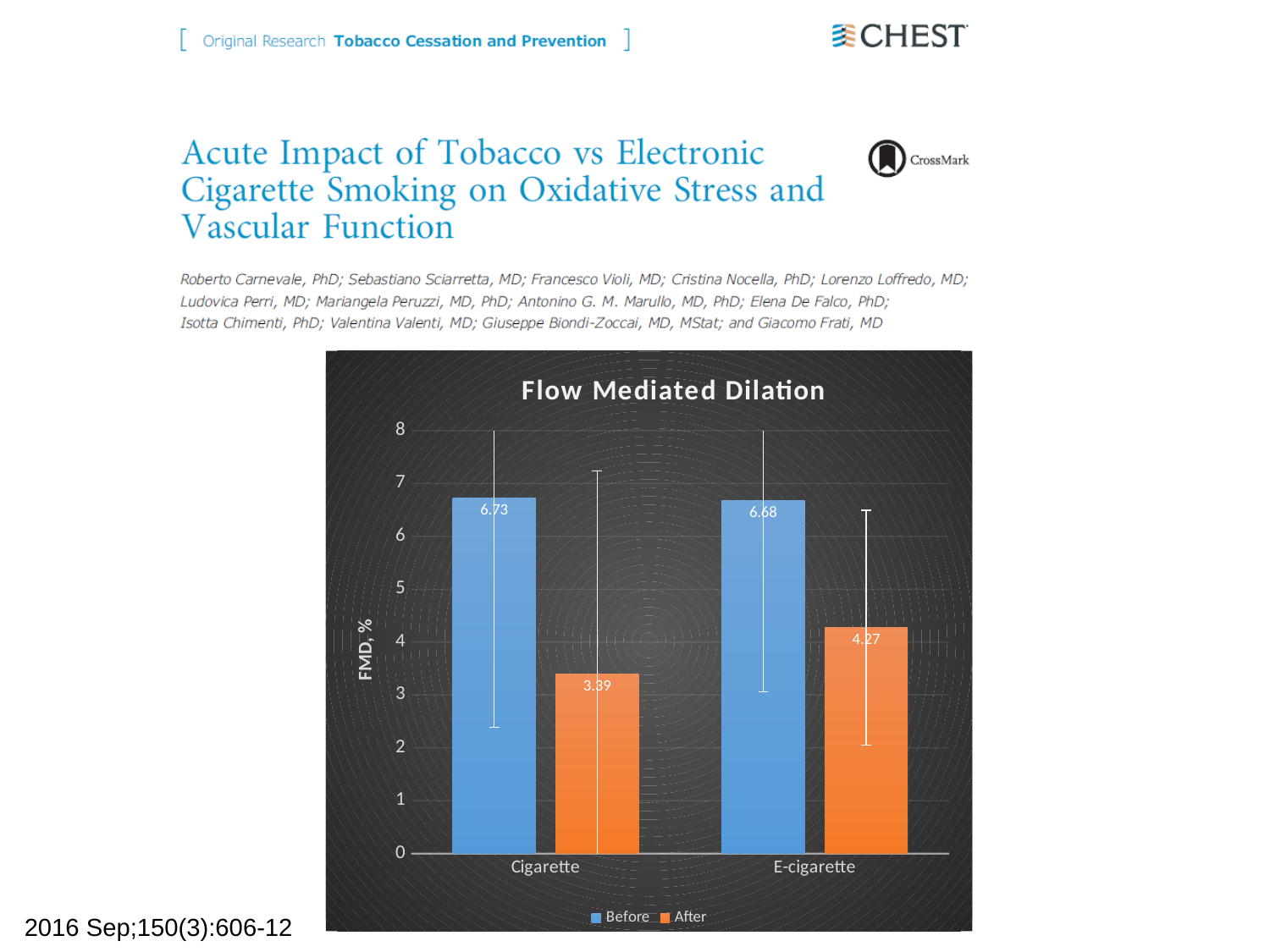
Which is larger, the After value for Cigarette or the After value for E-cigarette? E-cigarette What is the Before value for E-cigarette? 6.68 What is the difference between the After values for E-cigarette and Cigarette? 0.88 Which bar has the lowest value in the chart? Cigarette, After What is the label of the y axis? FMD, % What is the After value for E-cigarette in the Flow Mediated Dilation chart? 4.27 How many categories are shown on the x axis? 2 How many series does the legend list? 2 What kind of chart is shown on the slide? Bar chart What is the difference between the Before and After values for Cigarette? 3.34 What is the After value for Cigarette? 3.39 What is the Before value for Cigarette in the Flow Mediated Dilation chart? 6.73